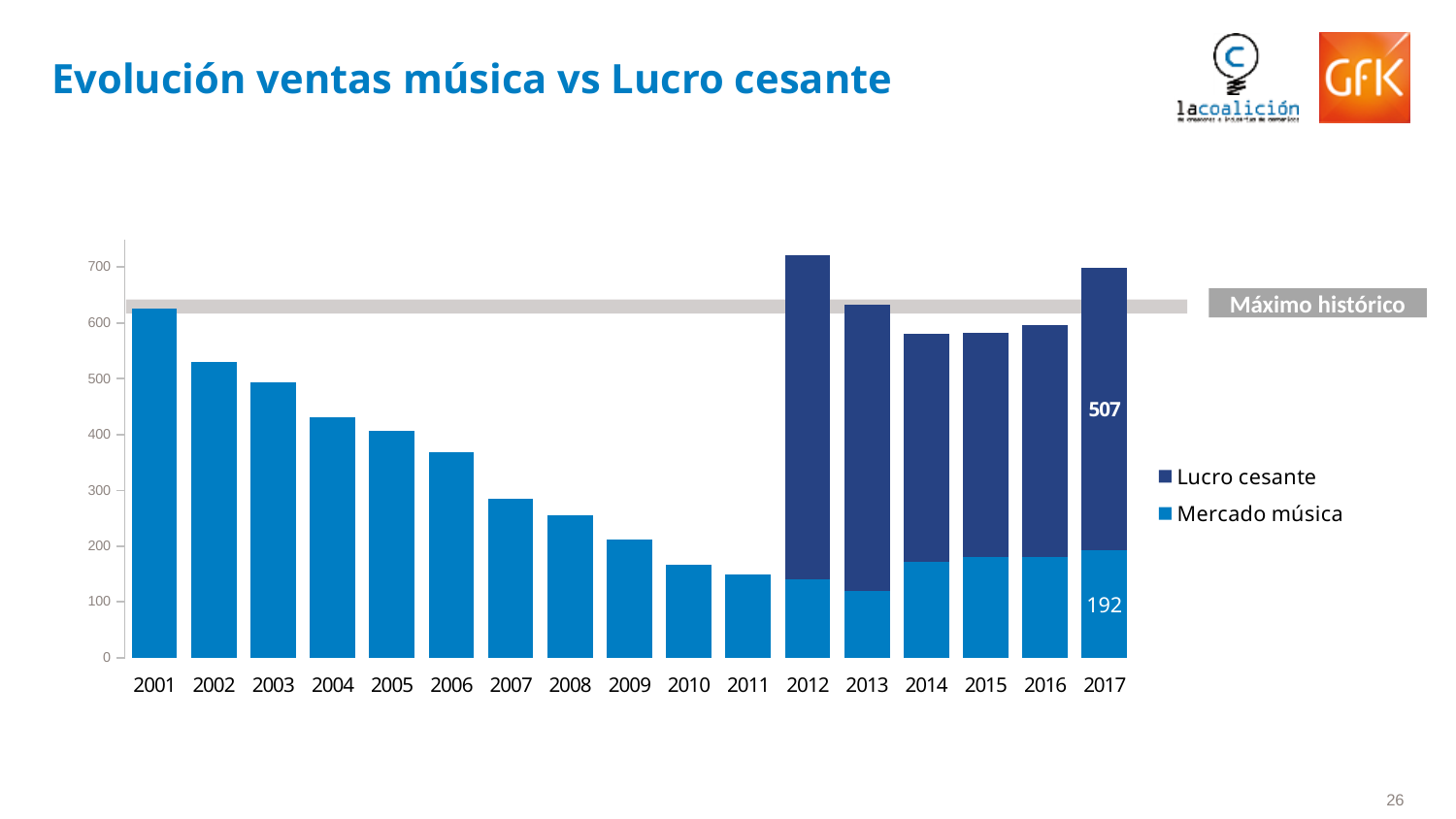
What is the value of Mercado música for 2017? 192 How many years are shown on the x axis? 17 Does the Mercado música value rise or fall from 2001 to 2011? Fall What is the value of Lucro cesante for 2017? 507 Is the Mercado música value for 2001 greater or less than 600? greater Is the Mercado música value for 2011 greater or less than 200? less Which year has the highest Mercado música value? 2001 What kind of chart is shown on the slide? Stacked bar chart Which is larger, the total stacked bar for 2012 or for 2013? 2012 What are the two series named in the legend? Lucro cesante and Mercado música How many series does the legend list? 2 What is the total of the stacked bar for 2017? 699